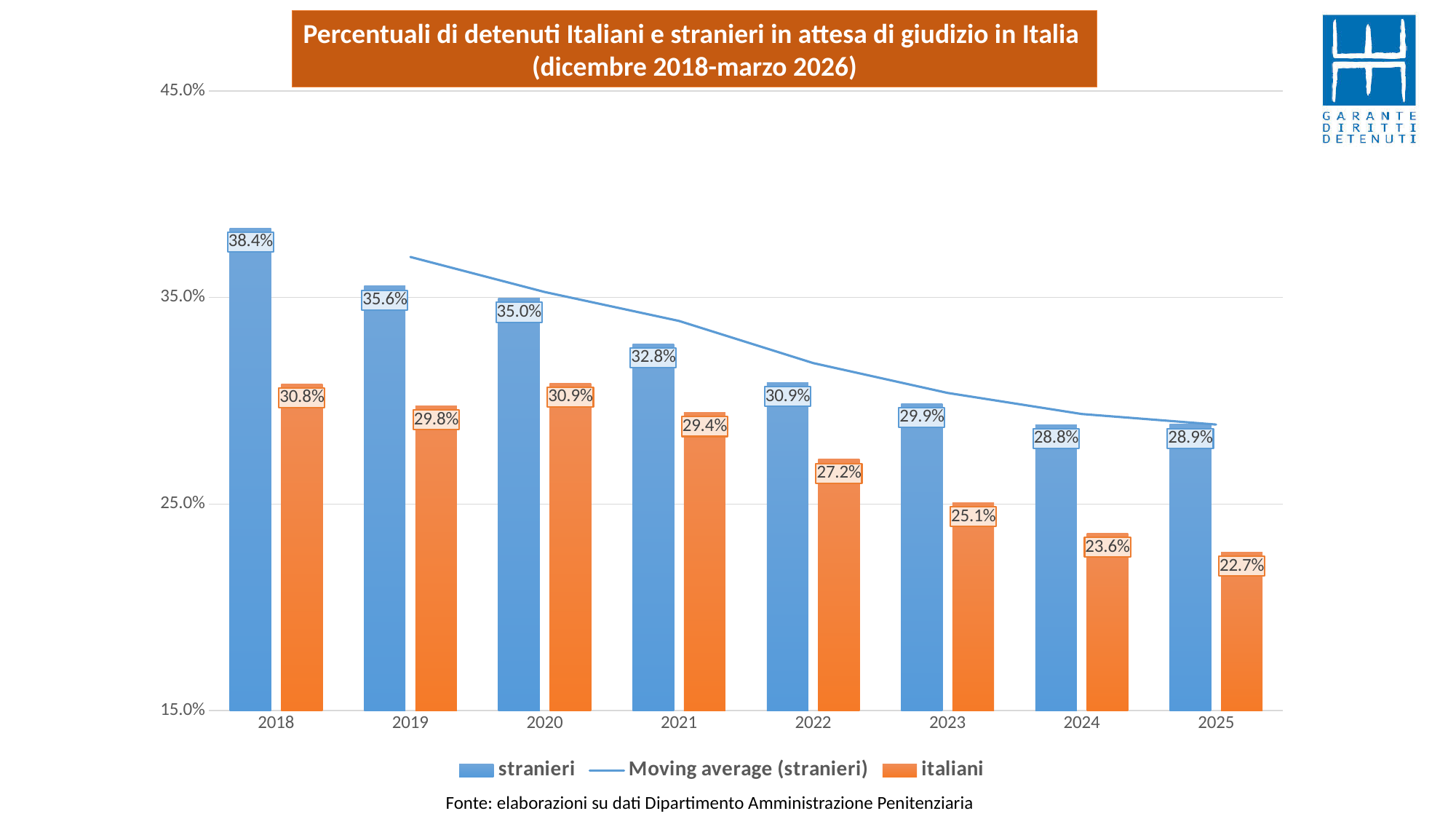
What is the difference between the stranieri and italiani values in 2018? 7.6% Which year has the highest value for stranieri? 2018 How many series does the legend list? 3 Which is larger in 2021, the value for stranieri or the value for italiani? stranieri What is the value for italiani in 2022? 27.2% Is the value for italiani in 2023 greater or less than 25.0%? greater What kind of chart is this? bar chart with a line What is the value for italiani in 2025? 22.7% What is the value for stranieri in 2018? 38.4% Do the values for italiani rise or fall from 2020 to 2025? fall Which year has the lowest value for italiani? 2025 How many years are shown on the x axis? 8